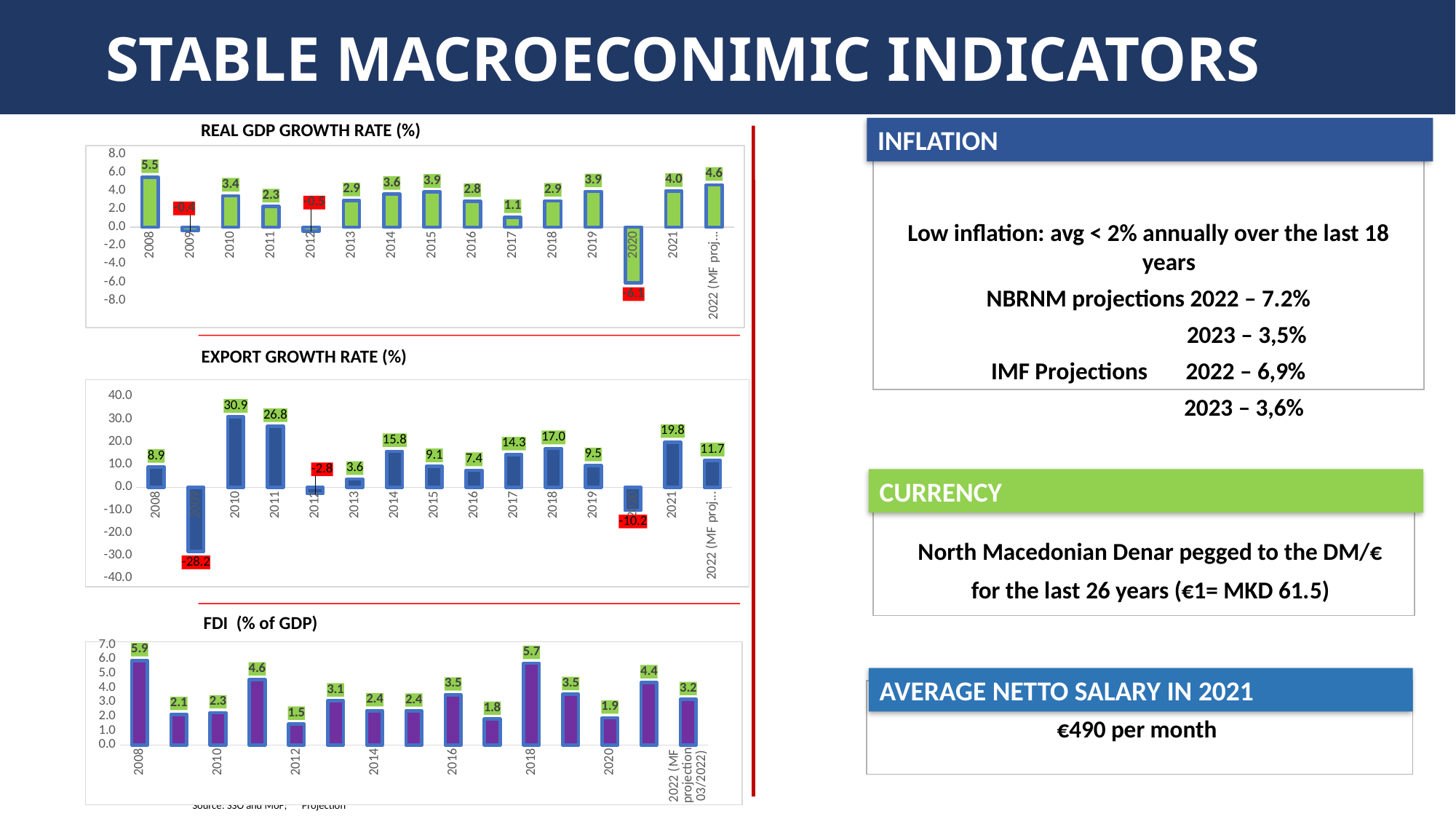
In the REAL GDP GROWTH RATE (%) chart, what is the difference between the 2021 value and the 2017 value? 2.9 In the EXPORT GROWTH RATE (%) chart, what is the value for 2021? 19.8 In the REAL GDP GROWTH RATE (%) chart, what is the value for 2022 (IMF projection)? 4.6 In the EXPORT GROWTH RATE (%) chart, which is larger, the value for 2018 or the value for 2014? 2018 In the EXPORT GROWTH RATE (%) chart, which year has the highest value? 2010 In the EXPORT GROWTH RATE (%) chart, which year has the lowest value? 2009 What type of chart is the FDI (% of GDP) chart? Bar chart In the REAL GDP GROWTH RATE (%) chart, what is the value for 2008? 5.5 How many bars are plotted in the EXPORT GROWTH RATE (%) chart? 15 In the FDI (% of GDP) chart, what is the value for 2018? 5.7 In the FDI (% of GDP) chart, what is the difference between the 2008 value and the 2020 value? 4.0 In the FDI (% of GDP) chart, which year has the highest value? 2008